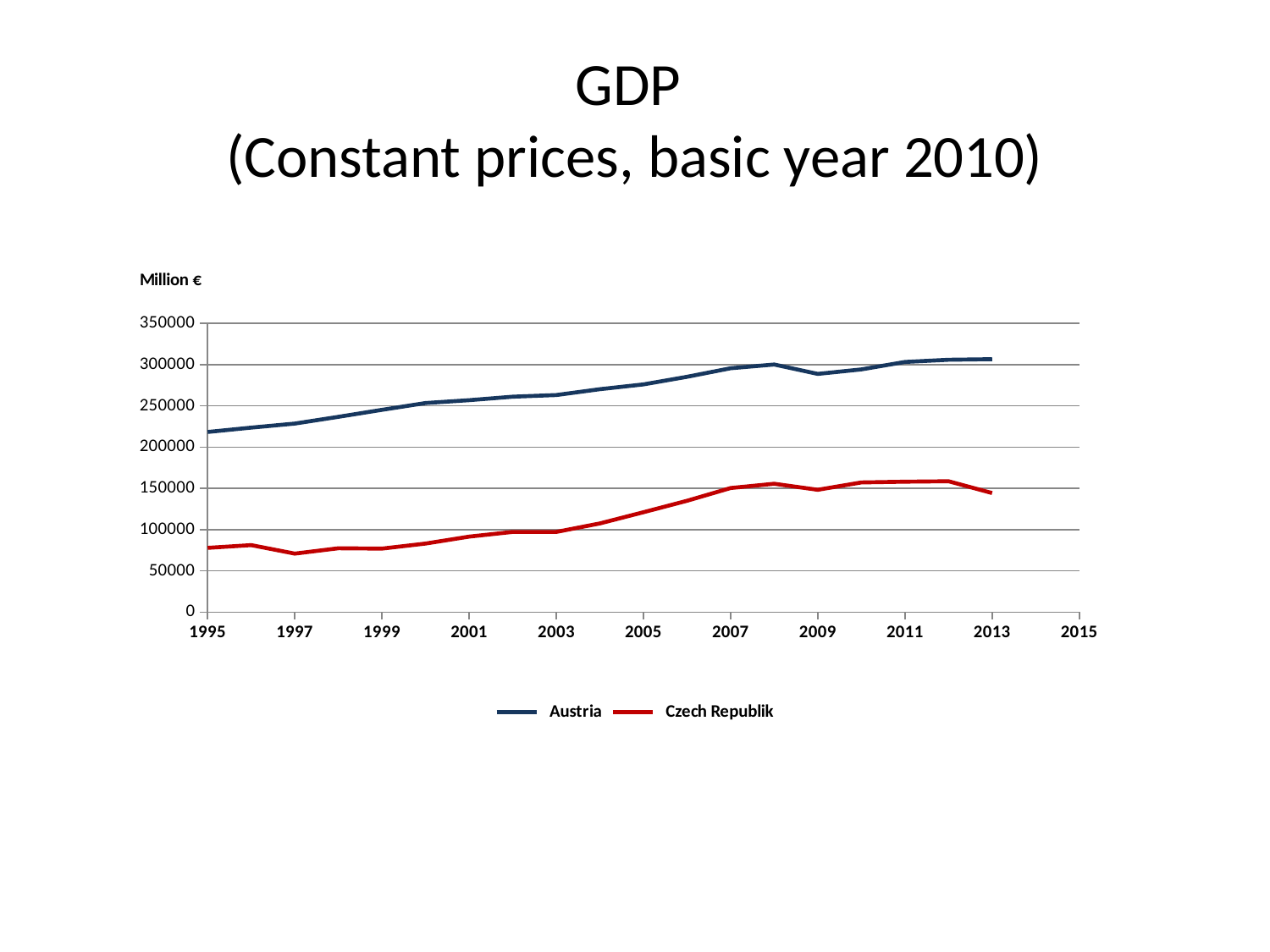
Which series has the larger value in 2005, Austria or Czech Republik? Austria Is the value for Austria in 2013 greater or less than 300000? greater How many series does the legend list? 2 Is the value for Austria in 1995 greater or less than 200000? greater Is the value for Austria in 2009 greater or less than 300000? less Does the Austria line generally rise or fall from 1995 to 2013? rise What unit is shown on the vertical axis label? Million € What kind of chart is shown on the slide? line chart Which two series are listed in the legend? Austria and Czech Republik